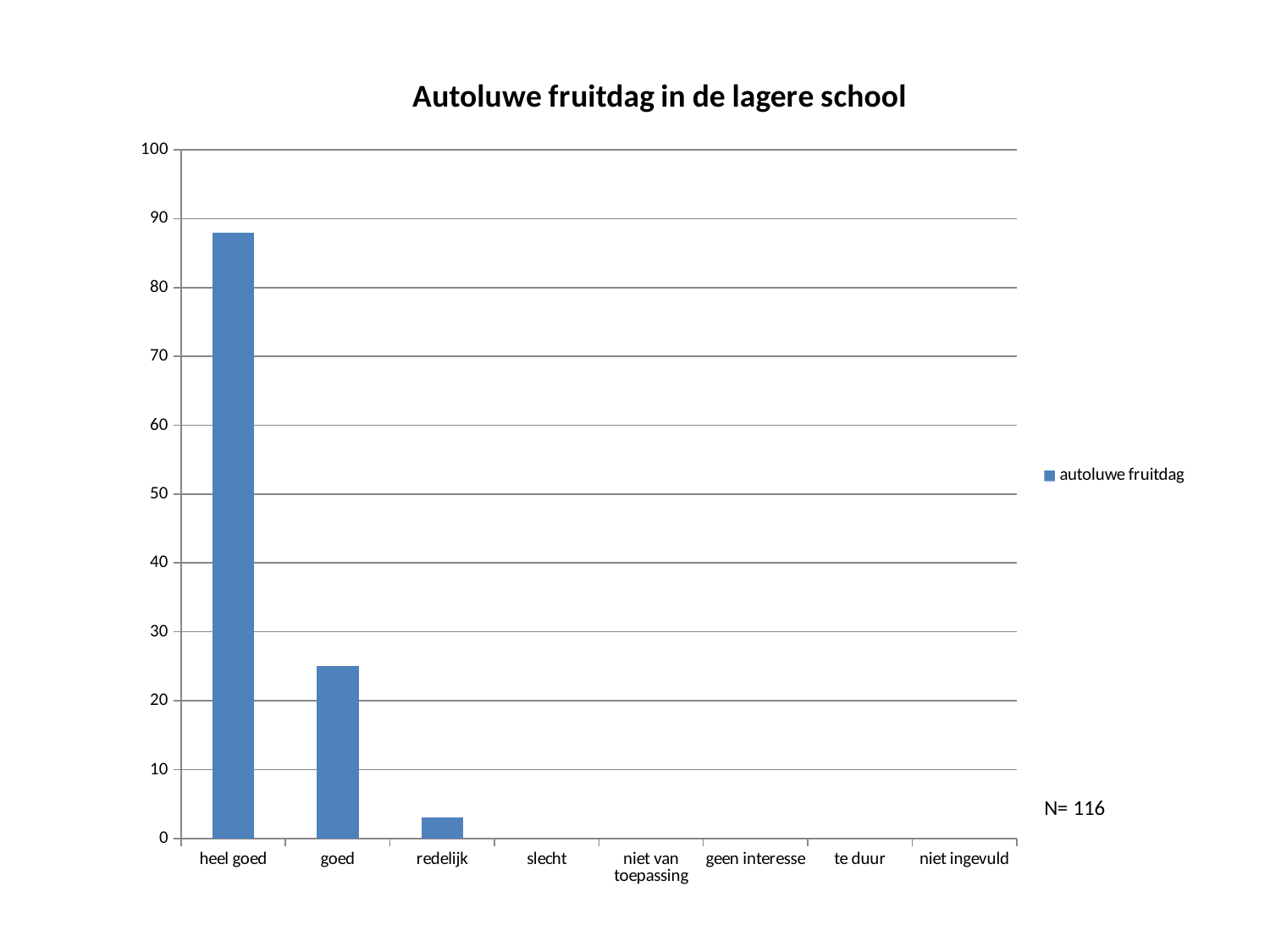
Is the value for goed greater or less than 30? less How many series does the legend list? 1 Which category has the highest value? heel goed What kind of chart is shown on the slide? bar chart Is the value for goed greater or less than 20? greater Which is larger, the value for heel goed or the value for goed? heel goed What is the title of the chart? Autoluwe fruitdag in de lagere school Is the value for redelijk greater or less than 10? less How many categories are shown on the x axis of the chart? 8 What is the name of the series in the legend? autoluwe fruitdag Which is larger, the value for goed or the value for redelijk? goed